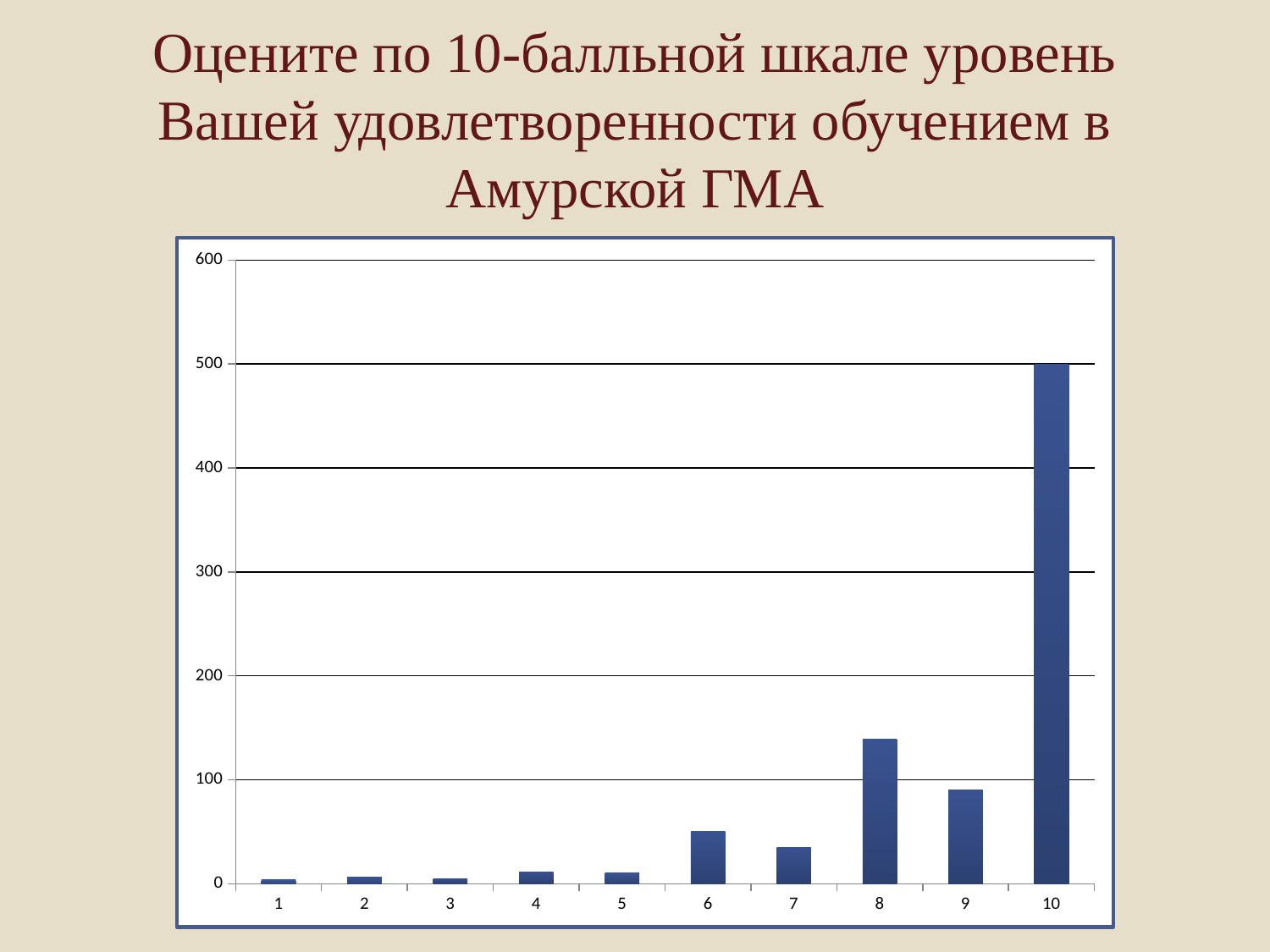
Is the value for category 10 greater or less than 400? greater What is the highest value shown on the vertical axis of the chart? 600 What kind of chart is shown on the slide? bar chart Is the value for category 8 greater or less than 100? greater Which is larger, the value for category 6 or the value for category 7? 6 What is the value for category 10 in the chart? 500 Is the value for category 9 greater or less than 100? less Which is larger, the value for category 8 or the value for category 9? 8 Which category has the highest bar in the chart? 10 How many categories are shown on the x axis of the chart? 10 Do the values generally rise or fall as the categories go from 1 to 10? rise